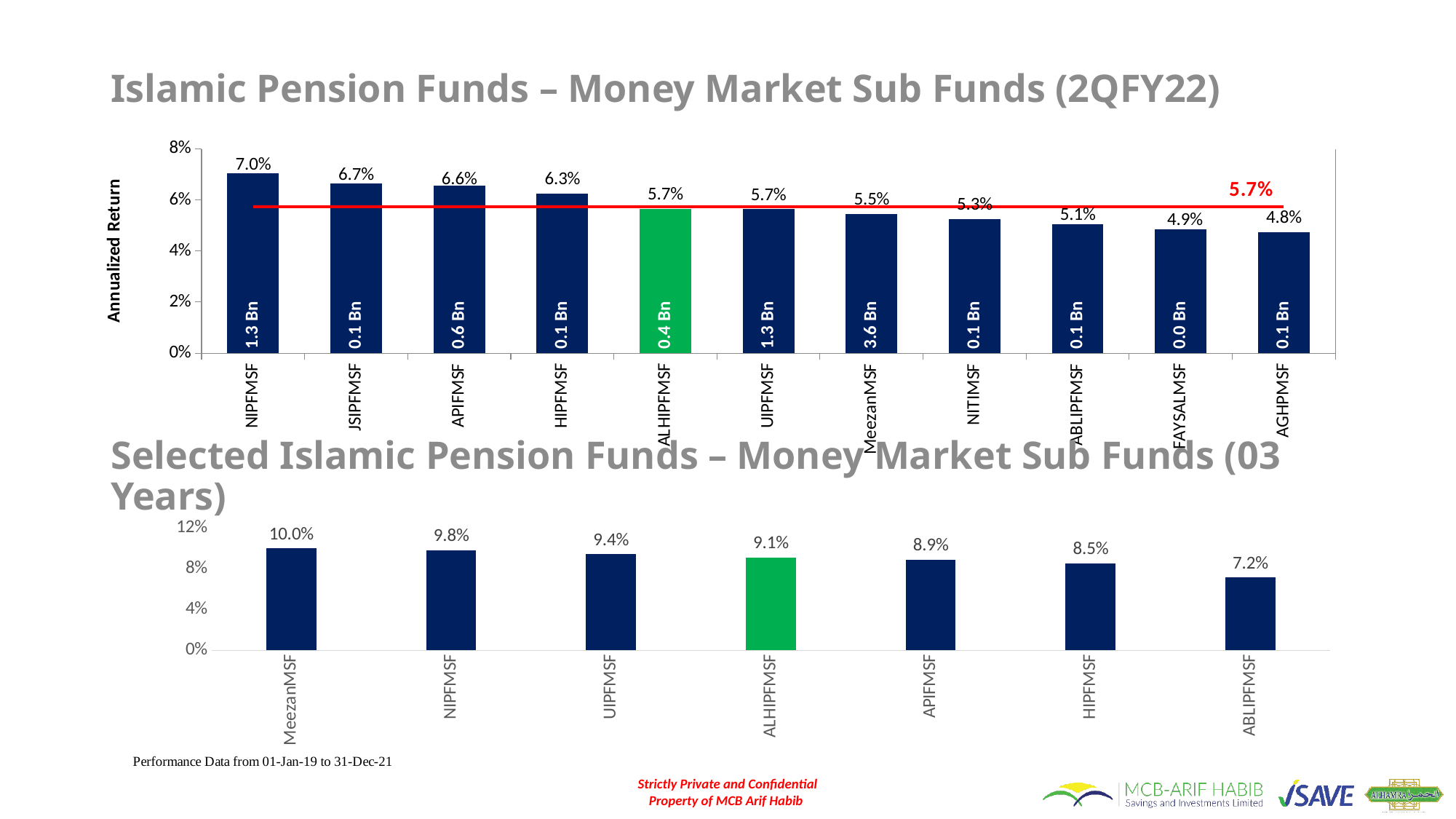
In the bottom chart (03 Years), how many funds are plotted? 7 In the bottom chart (03 Years), which fund has the lowest return? ABLIPFMSF In the top chart (2QFY22), what value does the red horizontal line mark? 5.7% In the top chart (2QFY22), what is the difference between the returns of NIPFMSF and AGHPMSF? 2.2% In the bottom chart (03 Years), which is larger, the return for UIPFMSF or for HIPFMSF? UIPFMSF In the top chart (2QFY22), which fund has the lowest annualized return? AGHPMSF In the top chart (2QFY22), what is the annualized return for NIPFMSF? 7.0% In the bottom chart (03 Years), what is the return for MeezanMSF? 10.0% What type of chart is the bottom chart (03 Years)? Bar chart In the top chart (2QFY22), which fund has the highest annualized return? NIPFMSF In the top chart (2QFY22), what fund size is shown on the MeezanMSF bar? 3.6 Bn In the top chart (2QFY22), how many funds are plotted? 11